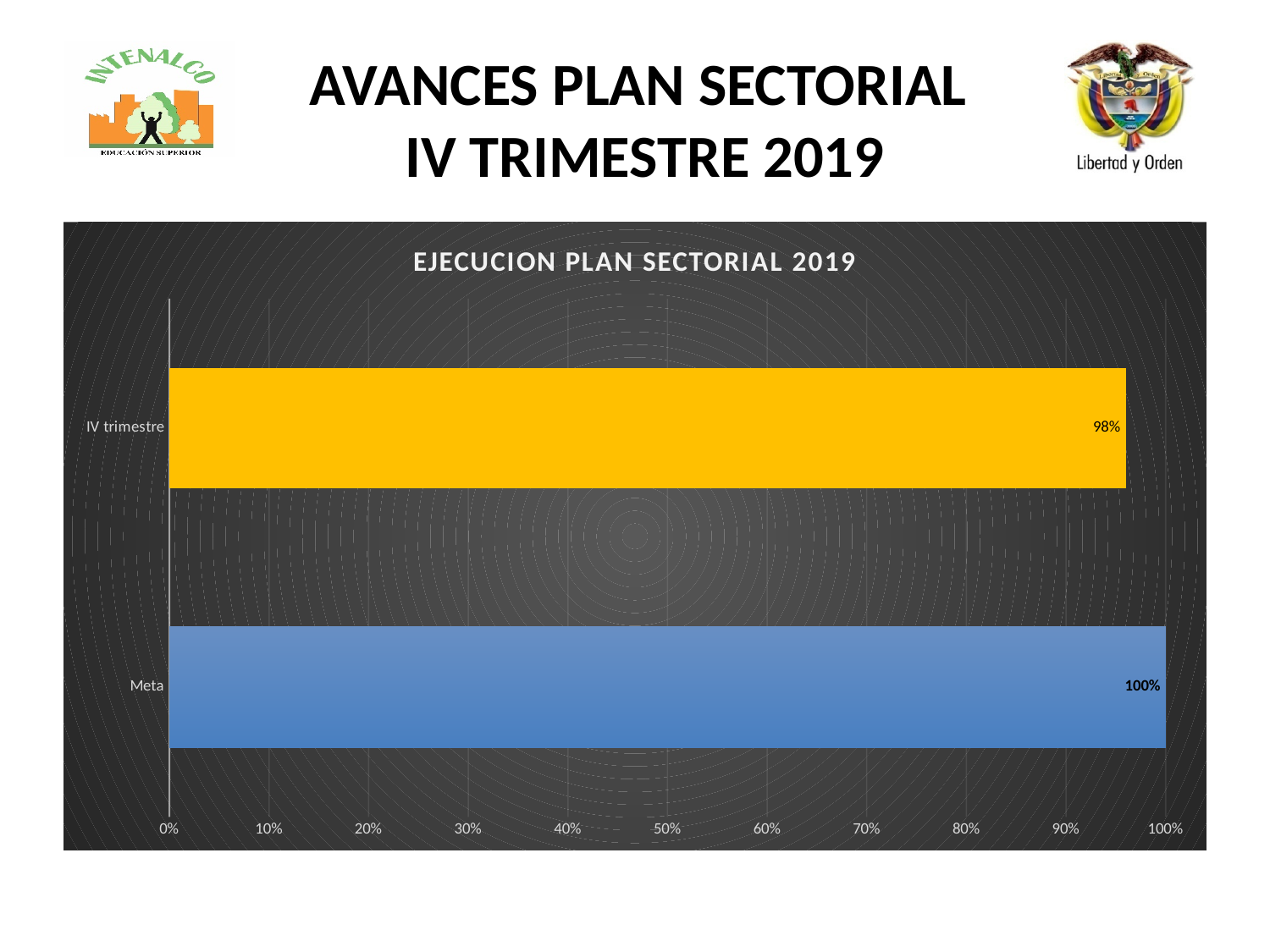
What colour is the bar for IV trimestre? yellow What kind of chart is shown on the slide? bar chart Which is larger, the value for Meta or the value for IV trimestre? Meta Which category has the highest value? Meta Which category has the lowest value? IV trimestre How many categories are shown in the chart? 2 What is the difference between the Meta value and the IV trimestre value? 2% What is the value for Meta? 100% What is the title of the chart? EJECUCION PLAN SECTORIAL 2019 Is the value for IV trimestre greater or less than 90%? greater What is the value for IV trimestre? 98%